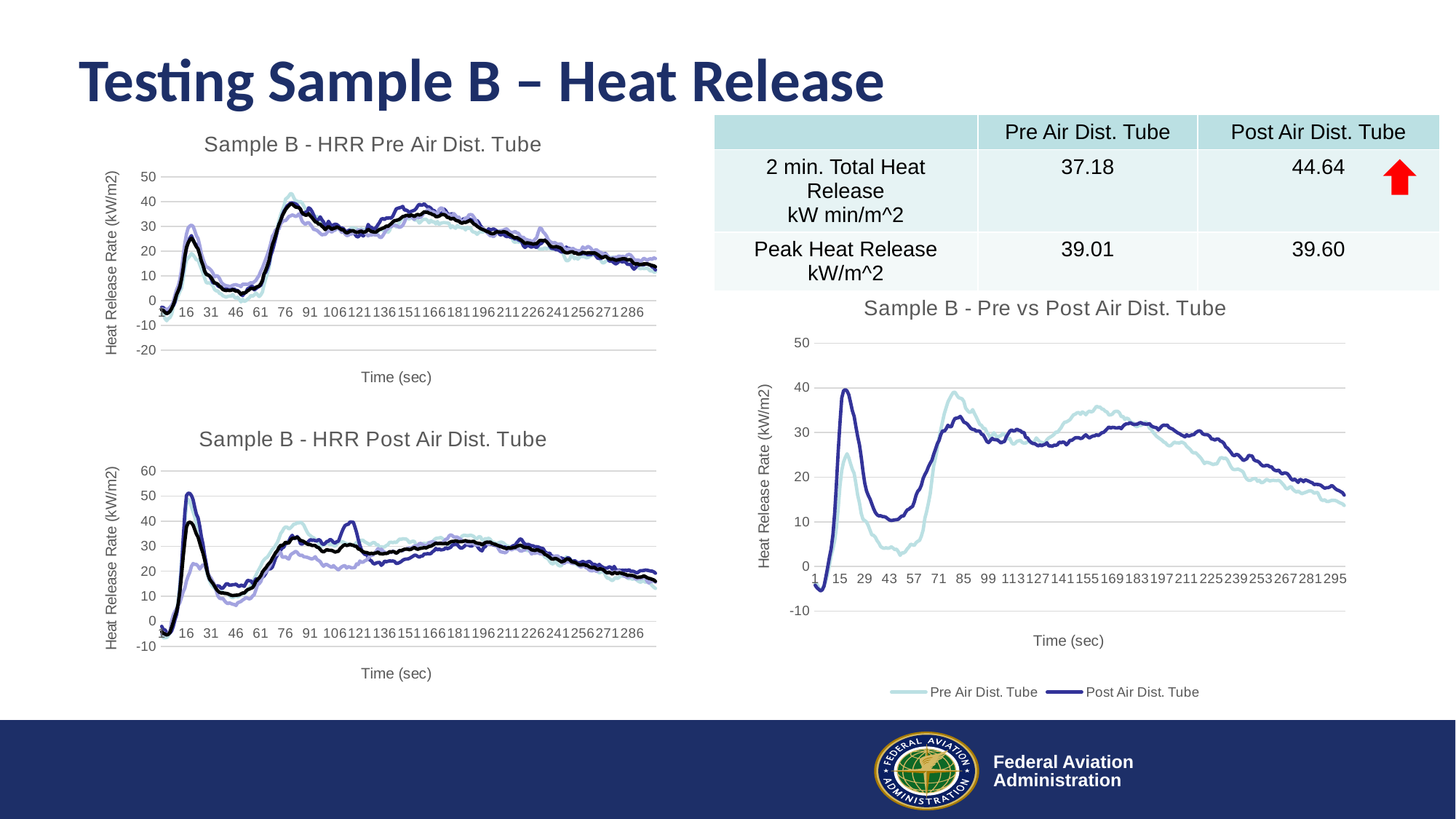
What kind of chart is "Sample B - HRR Pre Air Dist. Tube"? Line chart In the "Sample B - Pre vs Post Air Dist. Tube" chart, which series reaches the higher value near time 15? Post Air Dist. Tube How many series does the legend of the "Sample B - Pre vs Post Air Dist. Tube" chart list? 2 What kind of chart is "Sample B - Pre vs Post Air Dist. Tube"? Line chart In the "Sample B - HRR Pre Air Dist. Tube" chart, is the highest value reached by any line greater or less than 50? less In the "Sample B - Pre vs Post Air Dist. Tube" chart, is the first peak of the Pre Air Dist. Tube line (near time 15) greater or less than 30? less In the "Sample B - Pre vs Post Air Dist. Tube" chart, do the values rise or fall from time 183 to time 295? Fall In the "Sample B - HRR Post Air Dist. Tube" chart, is the highest value reached by any line greater or less than 40? greater What are the legend entries of the "Sample B - Pre vs Post Air Dist. Tube" chart? Pre Air Dist. Tube, Post Air Dist. Tube What is the x-axis title of the "Sample B - HRR Post Air Dist. Tube" chart? Time (sec)